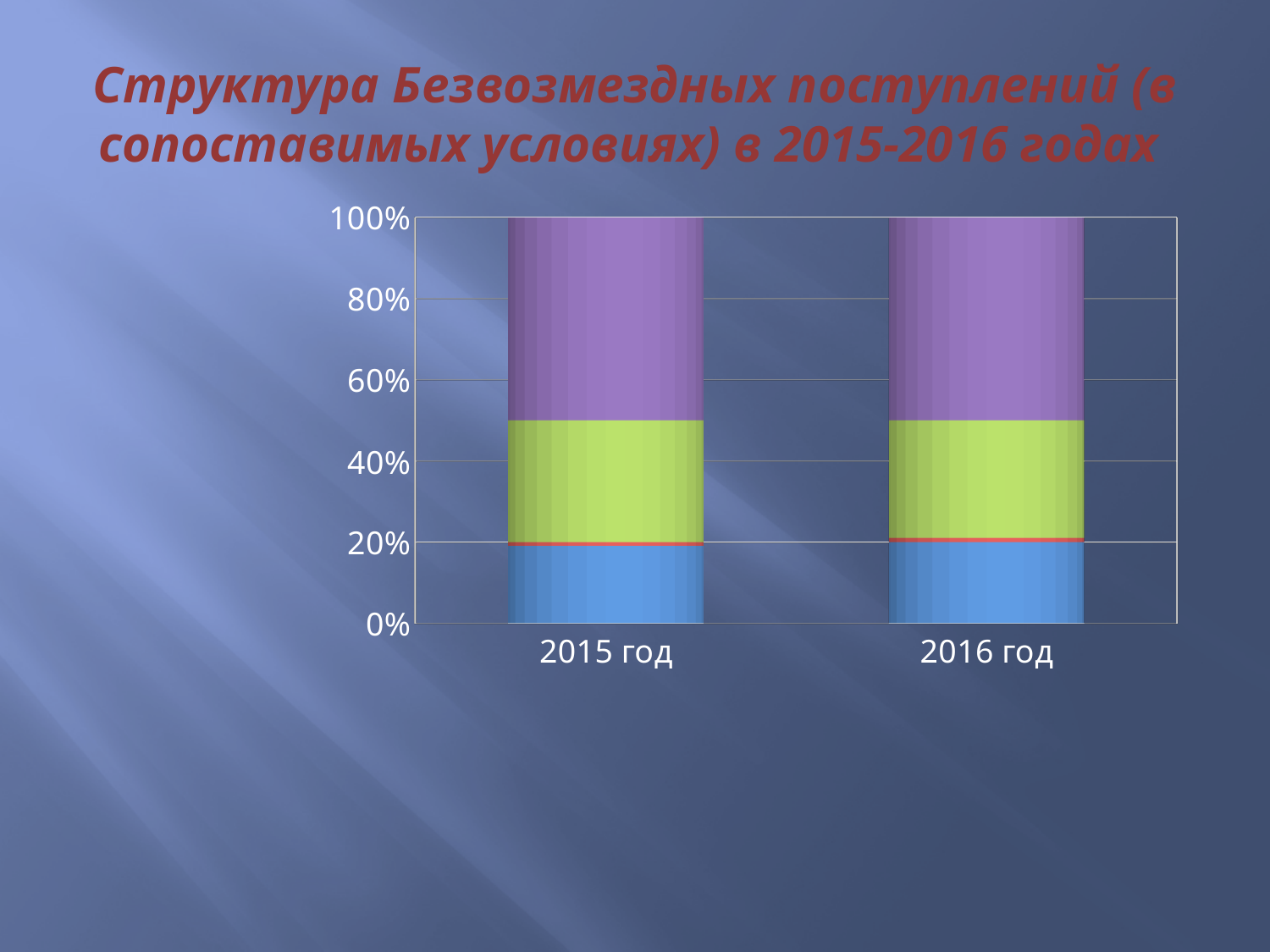
Is the top of the blue segment for 2016 год greater or less than 40%? less Is the top of the green segment for 2016 год greater or less than 60%? less Does the total height of the stacked bars change from 2015 год to 2016 год? No, both reach 100% What are the two categories on the x axis of the chart? 2015 год and 2016 год What is the title of the chart on the slide? Структура Безвозмездных поступлений (в сопоставимых условиях) в 2015-2016 годах What total does the stacked bar for 2015 год reach on the vertical axis? 100% What is the highest value shown on the vertical axis of the chart? 100% What total does the stacked bar for 2016 год reach on the vertical axis? 100% Is the top of the blue segment for 2015 год greater or less than 40%? less In the bar for 2015 год, which segment is larger: the purple one or the blue one? The purple one How many categories are shown on the x axis of the chart? 2 What type of chart is shown on the slide? Stacked bar chart